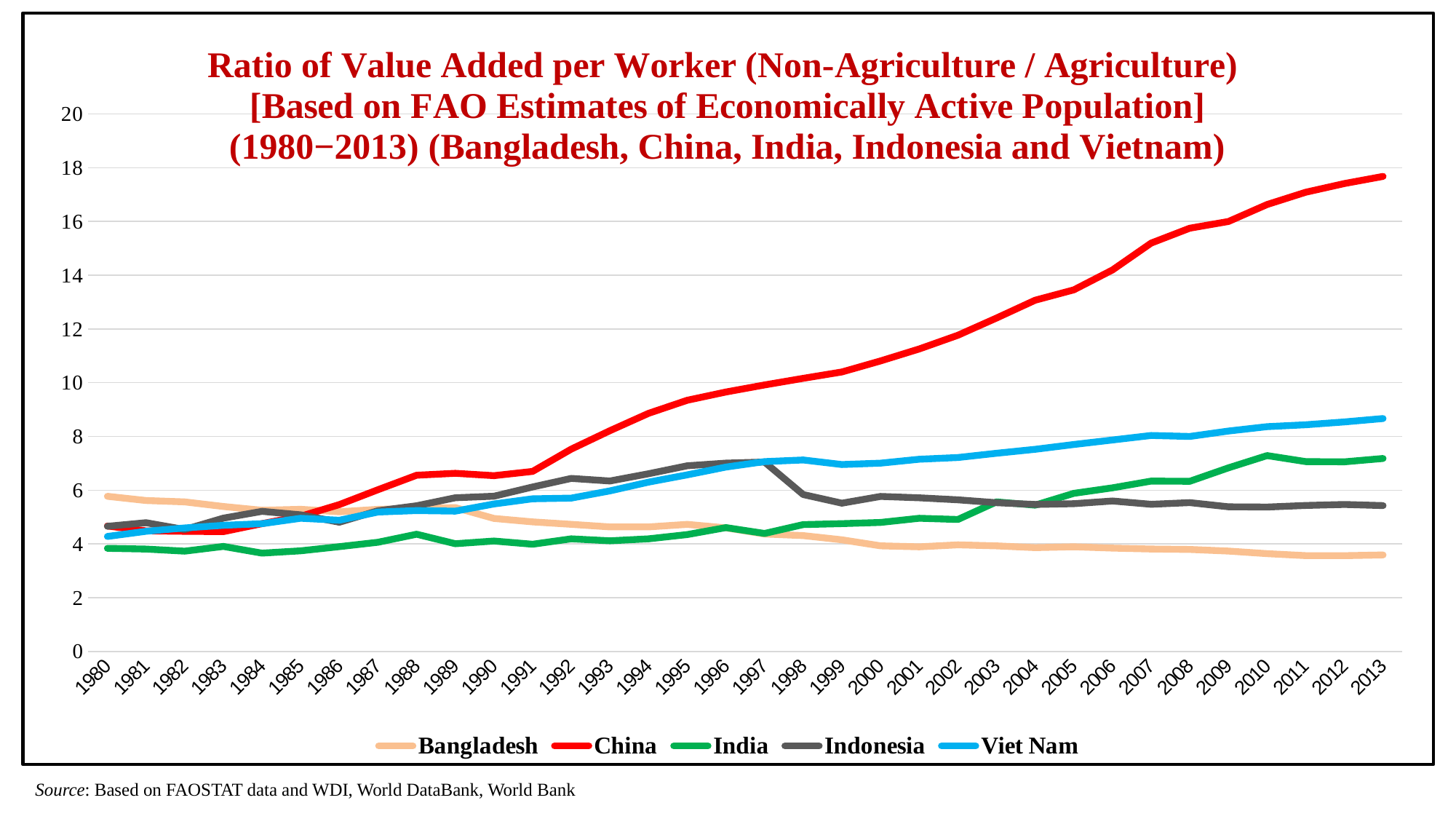
Is the value for Bangladesh in 2013 greater or less than 4? less Is the value for China in 2013 greater or less than 16? greater Which country has the lowest ratio in 2013? Bangladesh What kind of chart is shown on the slide? line chart Does the ratio for China rise or fall from 1980 to 2013? rise Which country has the highest ratio in 1980? Bangladesh How many series does the legend list? 5 Does the ratio for Bangladesh rise or fall from 1980 to 2013? fall Which country has the lowest ratio in 1980? India How many years are shown along the x axis? 34 In 2013, which is larger, the ratio for India or for Indonesia? India Which country has the highest ratio in 2013? China